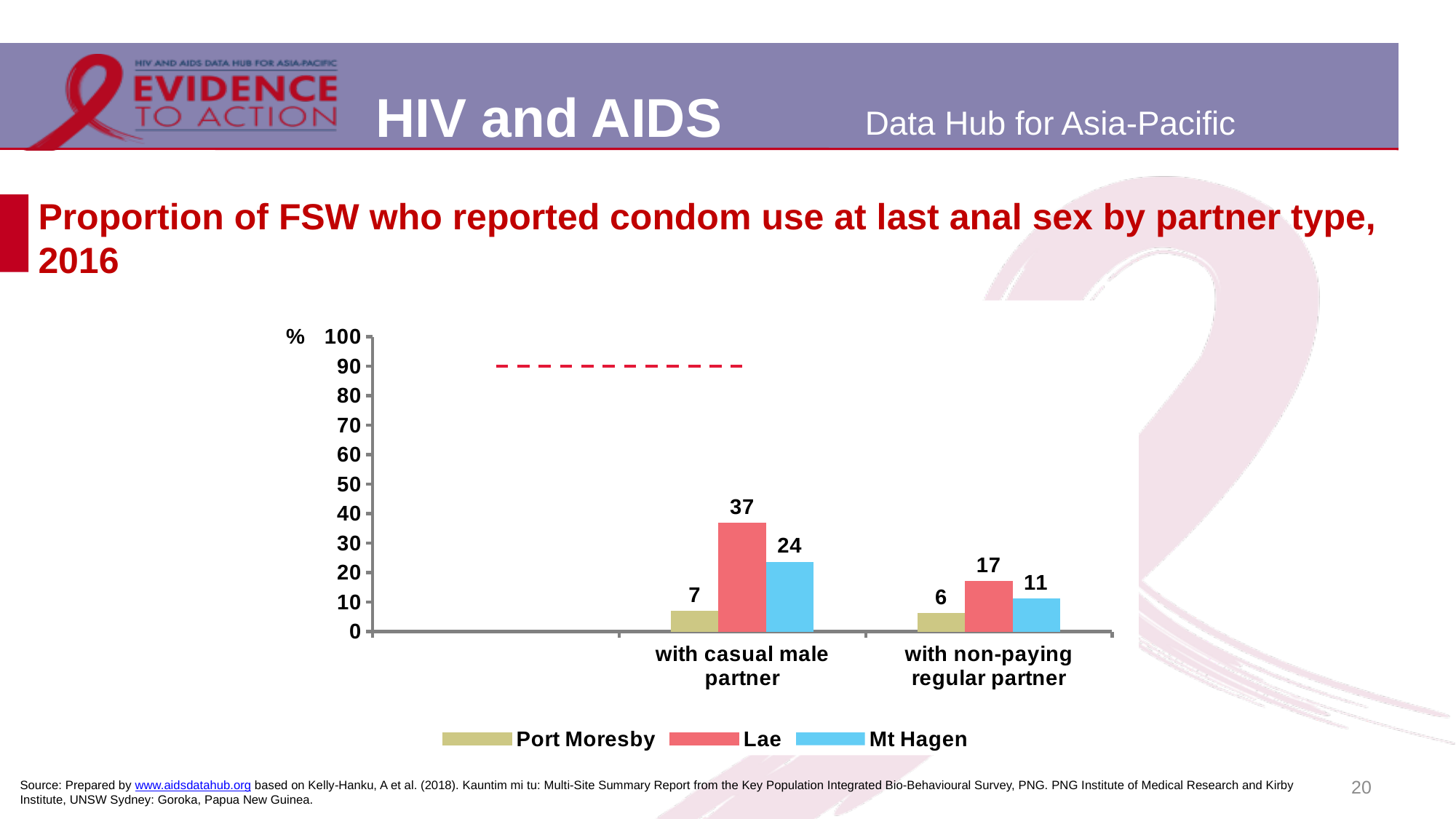
Which site has the highest value for condom use with casual male partner? Lae What kind of chart is shown on the slide? bar chart What is the value for Lae with casual male partner? 37 At what value on the y axis is the dashed horizontal line drawn? 90 What is the value for Port Moresby with non-paying regular partner? 6 How many partner-type categories are shown on the x axis? 2 Which is larger: the Mt Hagen value for casual male partner or the Mt Hagen value for non-paying regular partner? casual male partner What is the value for Mt Hagen with casual male partner? 24 Which site has the lowest value for condom use with non-paying regular partner? Port Moresby What is the difference between the Lae and Mt Hagen values for casual male partner? 13 What is the value for Lae with non-paying regular partner? 17 How many series does the legend list? 3